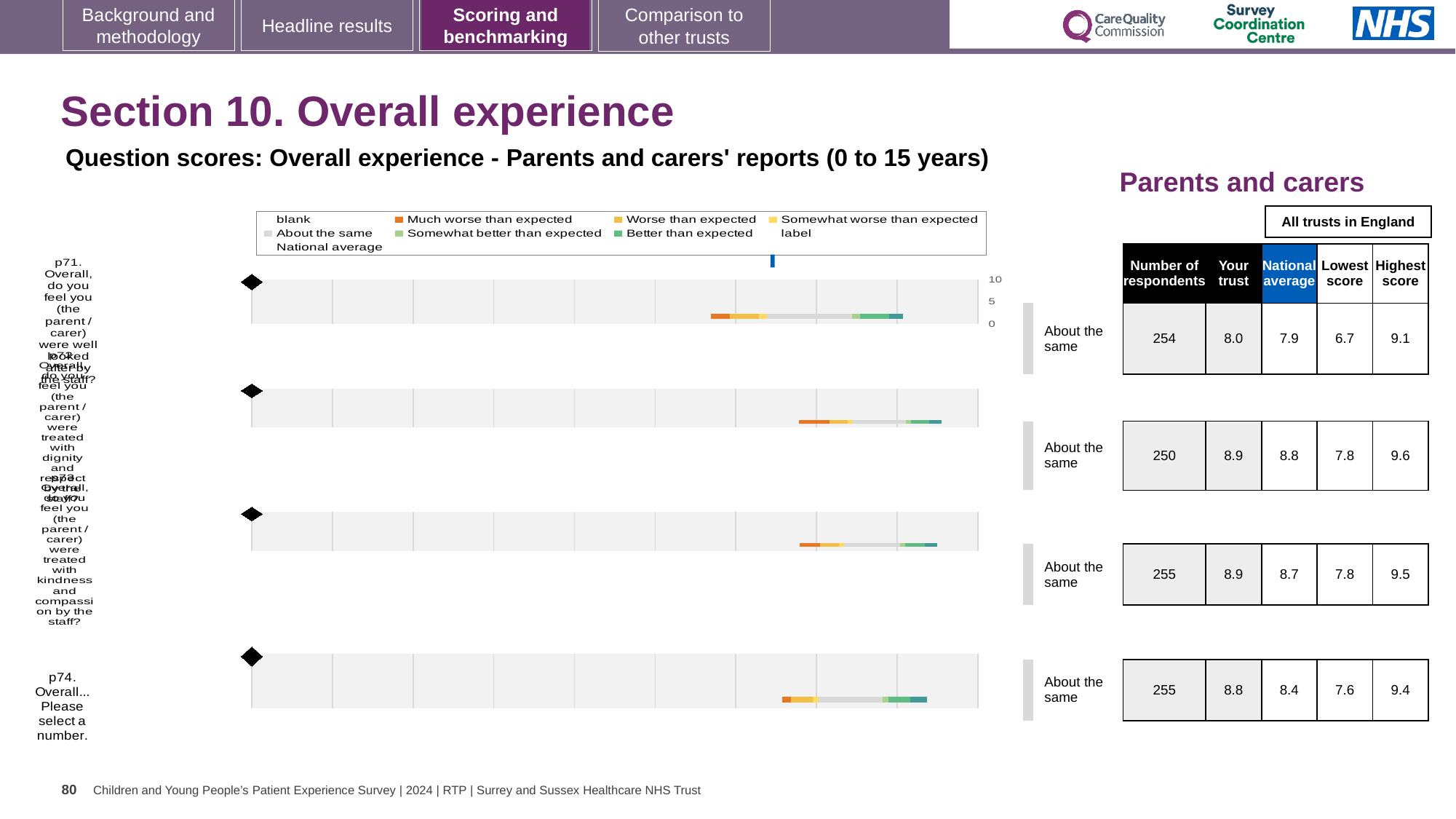
How many survey questions (rows) are plotted in the chart? 4 Which has the higher 'Your trust' score, question p72 or question p74? p72 How many entries does the chart legend list? 9 What is the subtitle describing the question scores shown on this slide? Question scores: Overall experience - Parents and carers' reports (0 to 15 years) For question p74, how much higher is the 'Your trust' score than the national average? 0.4 Which question has the highest 'Highest score' value in the table? p72 How many respondents answered question p72? 250 Which question has the lowest 'Lowest score' value in the table? p71 What kind of chart is used to show the question scores on this slide? bar chart What is the 'Your trust' score for question p71 in the table? 8.0 What benchmark category is shown for all four questions on this slide? About the same What is the national average score for question p74? 8.4